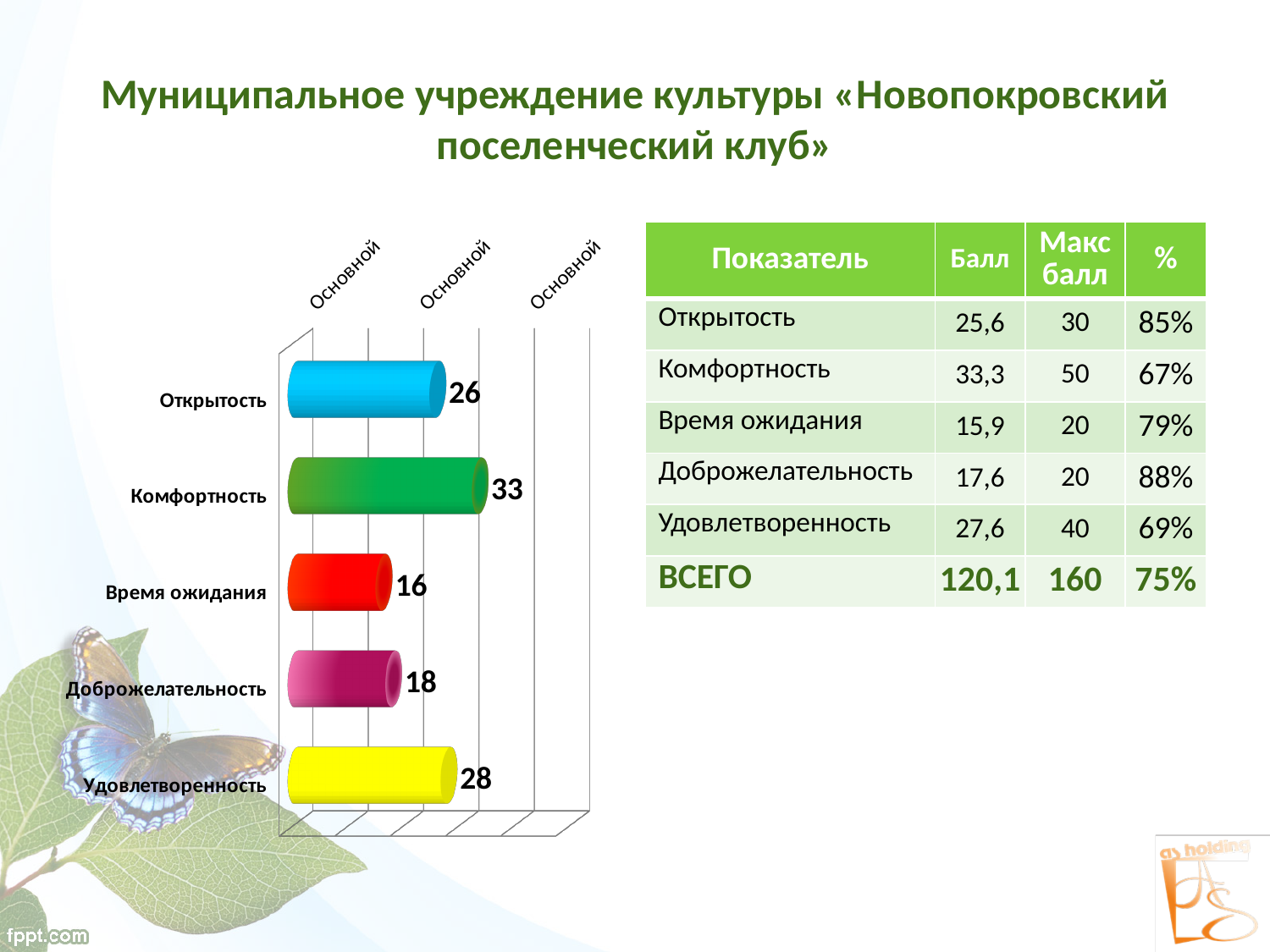
Which category has the highest value in the chart? Комфортность What value does the chart show for Открытость? 26 Which is larger in the chart, the value for Доброжелательность or the value for Открытость? Открытость How many categories are plotted in the chart? 5 What value does the chart show for Удовлетворенность? 28 What is the difference between the values for Комфортность and Время ожидания in the chart? 17 What is the difference between the values for Удовлетворенность and Открытость in the chart? 2 What value does the chart show for Комфортность? 33 Which category has the lowest value in the chart? Время ожидания What value does the chart show for Время ожидания? 16 What value does the chart show for Доброжелательность? 18 What kind of chart is shown on the slide? Bar chart